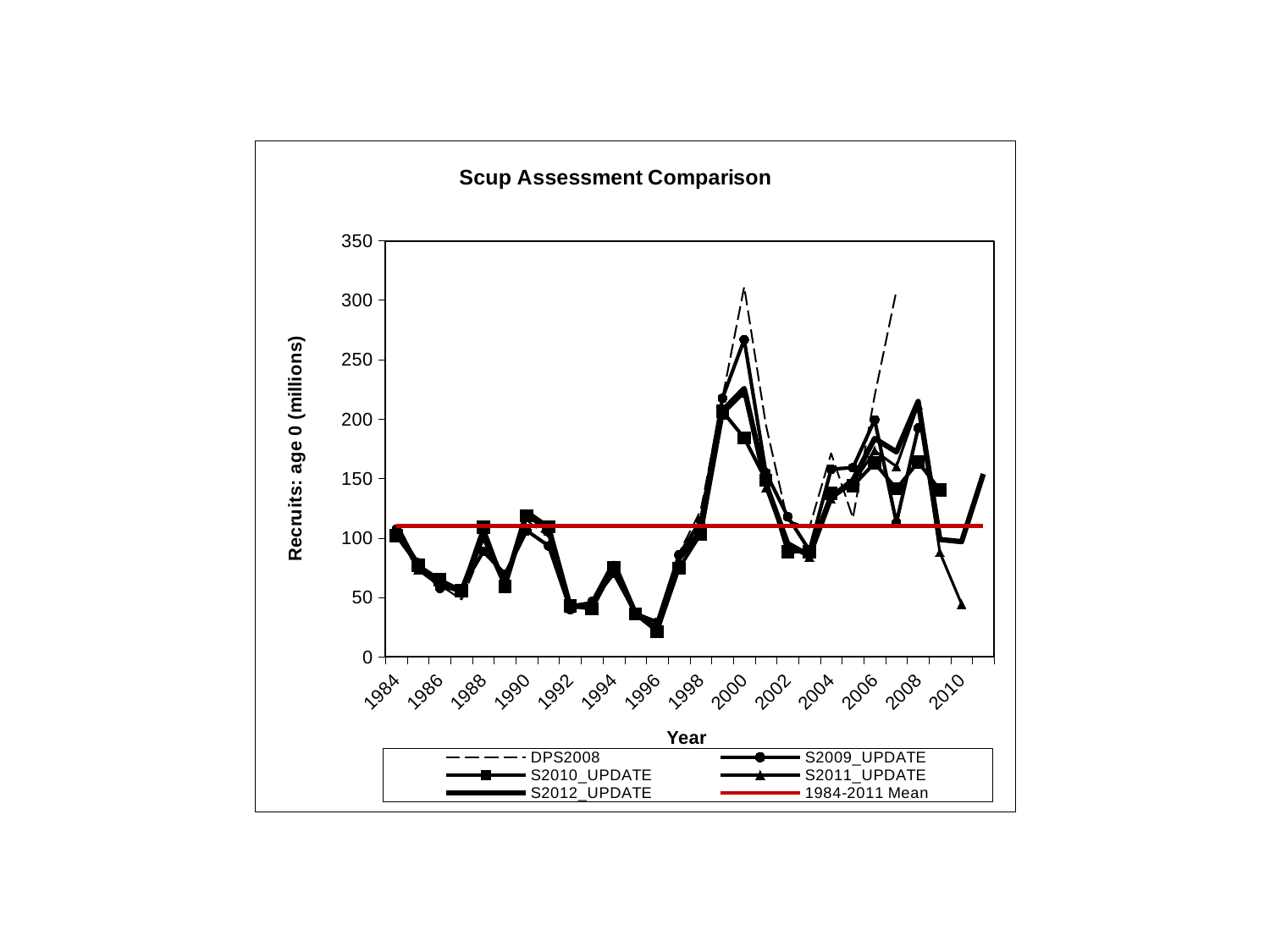
Do the values rise or fall from 1997 to 2000? rise Is the DPS2008 value for 2000 greater or less than 300? greater Which series is drawn as a red horizontal line? 1984-2011 Mean Is the value for 1990 greater or less than 100? greater Is the S2012_UPDATE value for 2008 greater or less than 200? greater What kind of chart is shown on the slide? line chart In which year does the S2009_UPDATE series reach its highest value? 2000 What is the title of the chart? Scup Assessment Comparison How many series does the legend list? 6